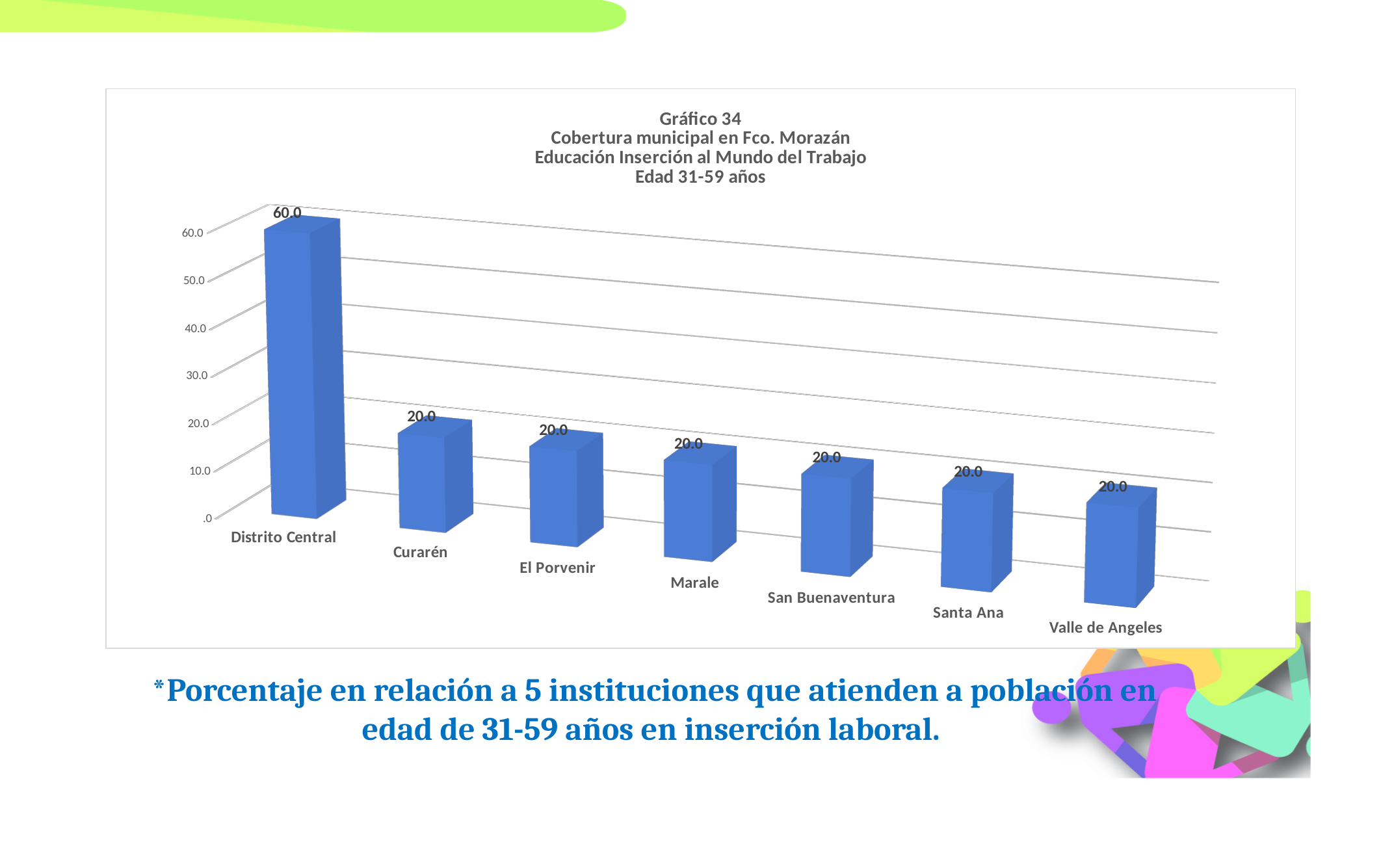
What kind of chart is shown on the slide? bar chart Is the value for El Porvenir greater or less than 30.0? less What is the value for Curarén? 20.0 What is the value for Valle de Angeles? 20.0 Which is larger, the value for Distrito Central or the value for Marale? Distrito Central Which municipality has the highest value? Distrito Central What is the value for Distrito Central? 60.0 What is the value for San Buenaventura? 20.0 What is the difference between the values for Distrito Central and Santa Ana? 40.0 How many municipalities are shown on the chart? 7 What age range is named in the chart title? 31-59 años How many municipalities have a value of 20.0? 6